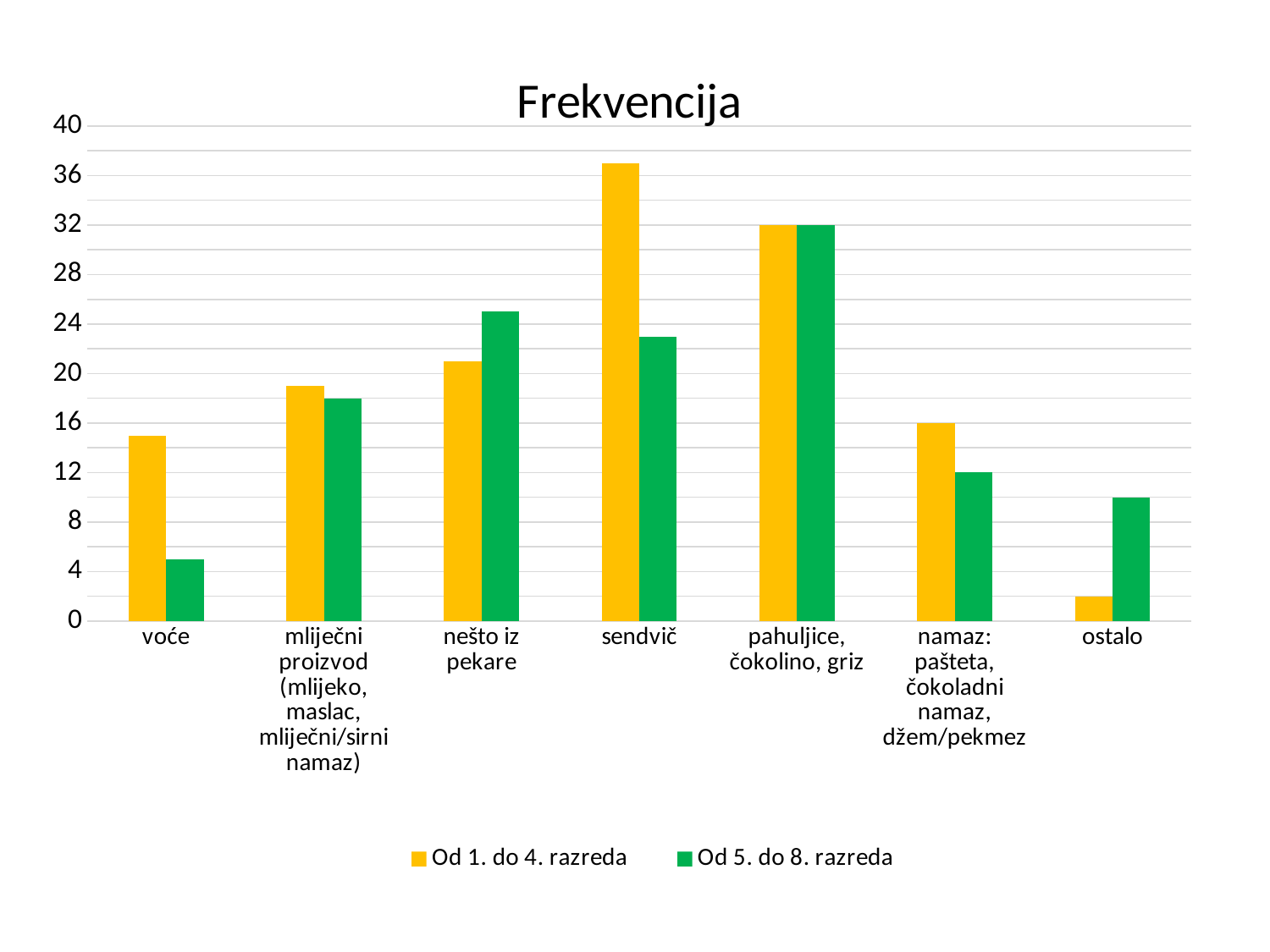
Is the value for voće for Od 5. do 8. razreda greater or less than 8? less Which category has the highest value for Od 1. do 4. razreda? sendvič What is the title of the chart? Frekvencija For ostalo, which series has the larger value, Od 1. do 4. razreda or Od 5. do 8. razreda? Od 5. do 8. razreda Which category has the lowest value for Od 1. do 4. razreda? ostalo What is the value for pahuljice, čokolino, griz for Od 5. do 8. razreda? 32 How many categories are shown on the x axis? 7 Which category has the lowest value for Od 5. do 8. razreda? voće Is the value for sendvič for Od 1. do 4. razreda greater or less than 36? greater Which category has the highest value for Od 5. do 8. razreda? pahuljice, čokolino, griz What kind of chart is shown on the slide? bar chart How many series does the legend list? 2